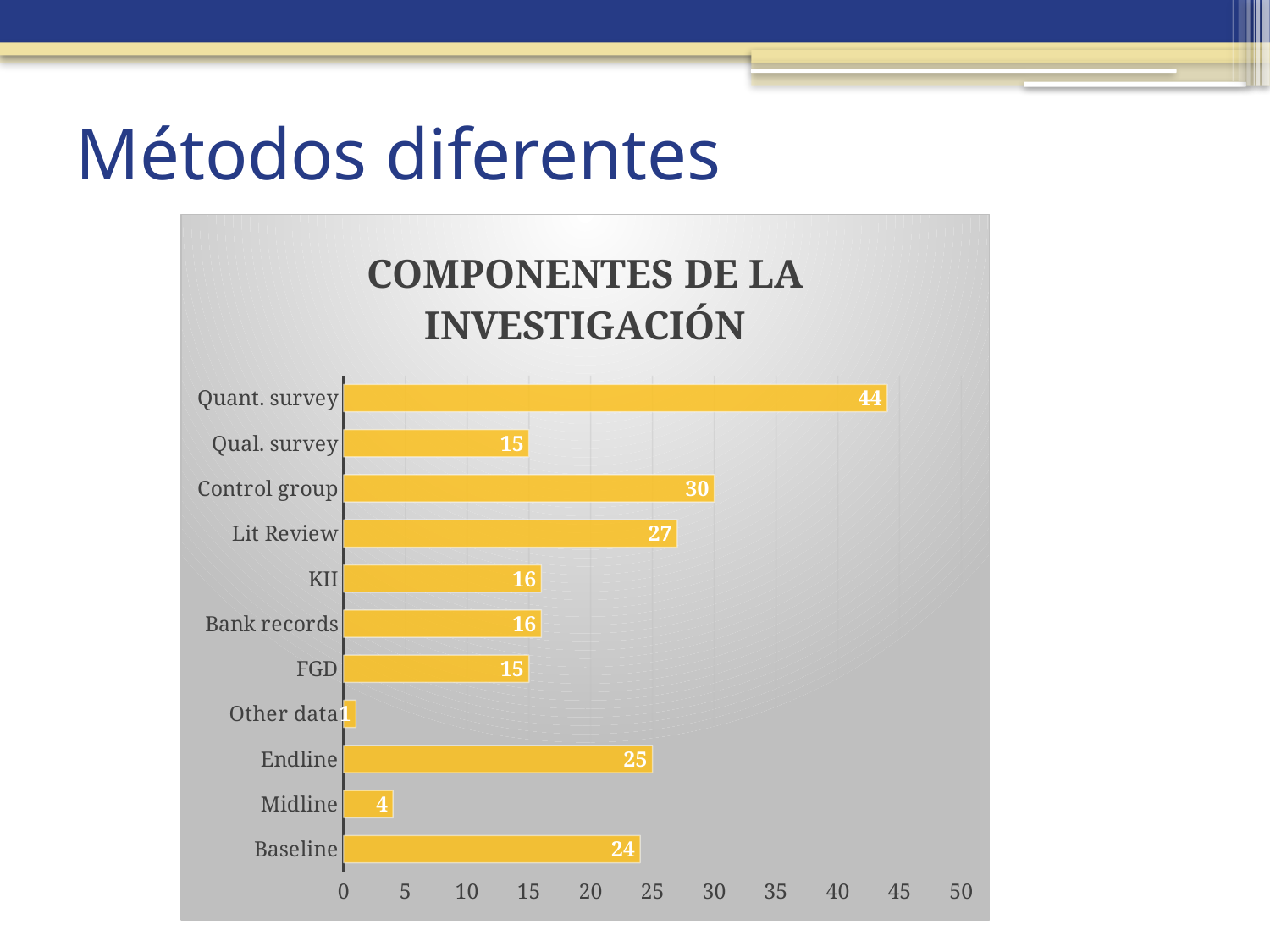
What is the difference between the values for Endline and Baseline? 1 Which category has the lowest value? Other data What is the value for Midline? 4 What kind of chart is shown on the slide? Bar chart Is the value for Baseline greater or less than 20? greater What is the title of the chart? COMPONENTES DE LA INVESTIGACIÓN What is the value for Control group? 30 Which is larger, the value for Lit Review or the value for Endline? Lit Review What is the value for Quant. survey? 44 How many categories are shown in the chart? 11 What is the difference between the values for Quant. survey and Control group? 14 Which category has the highest value? Quant. survey